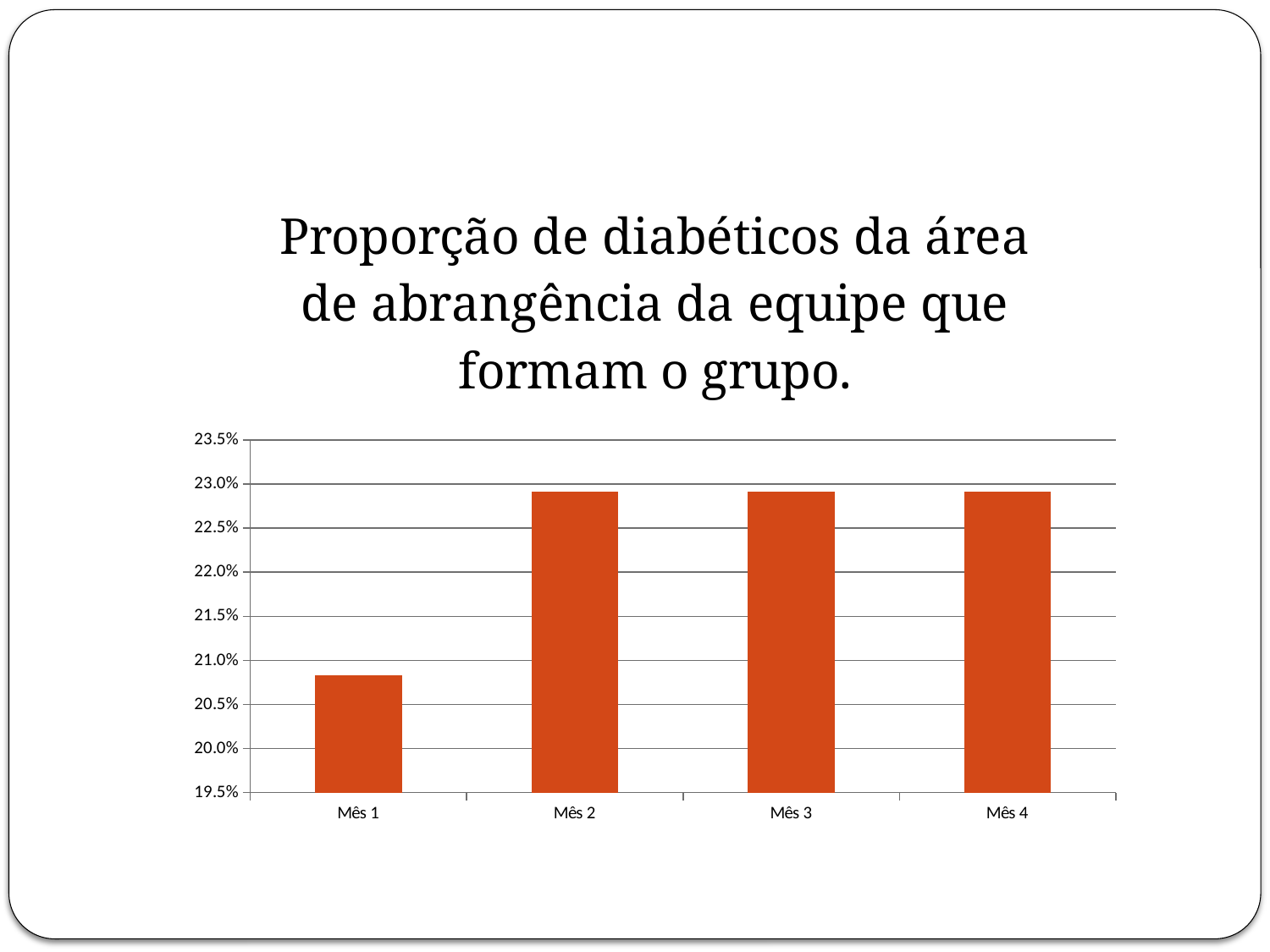
How many categories (months) are shown on the x axis? 4 What is the title of the chart? Proporção de diabéticos da área de abrangência da equipe que formam o grupo. Is the value for Mês 4 greater or less than 23.0%? less Is the value for Mês 1 greater or less than 20.5%? greater Which month has the lowest value? Mês 1 What kind of chart is shown on the slide? bar chart Which is larger, the value for Mês 1 or the value for Mês 3? Mês 3 What colour are the bars in the chart? orange Is the value for Mês 2 greater or less than 22.5%? greater Does the value rise or fall from Mês 1 to Mês 2? rise What is the lowest value shown on the y axis? 19.5%